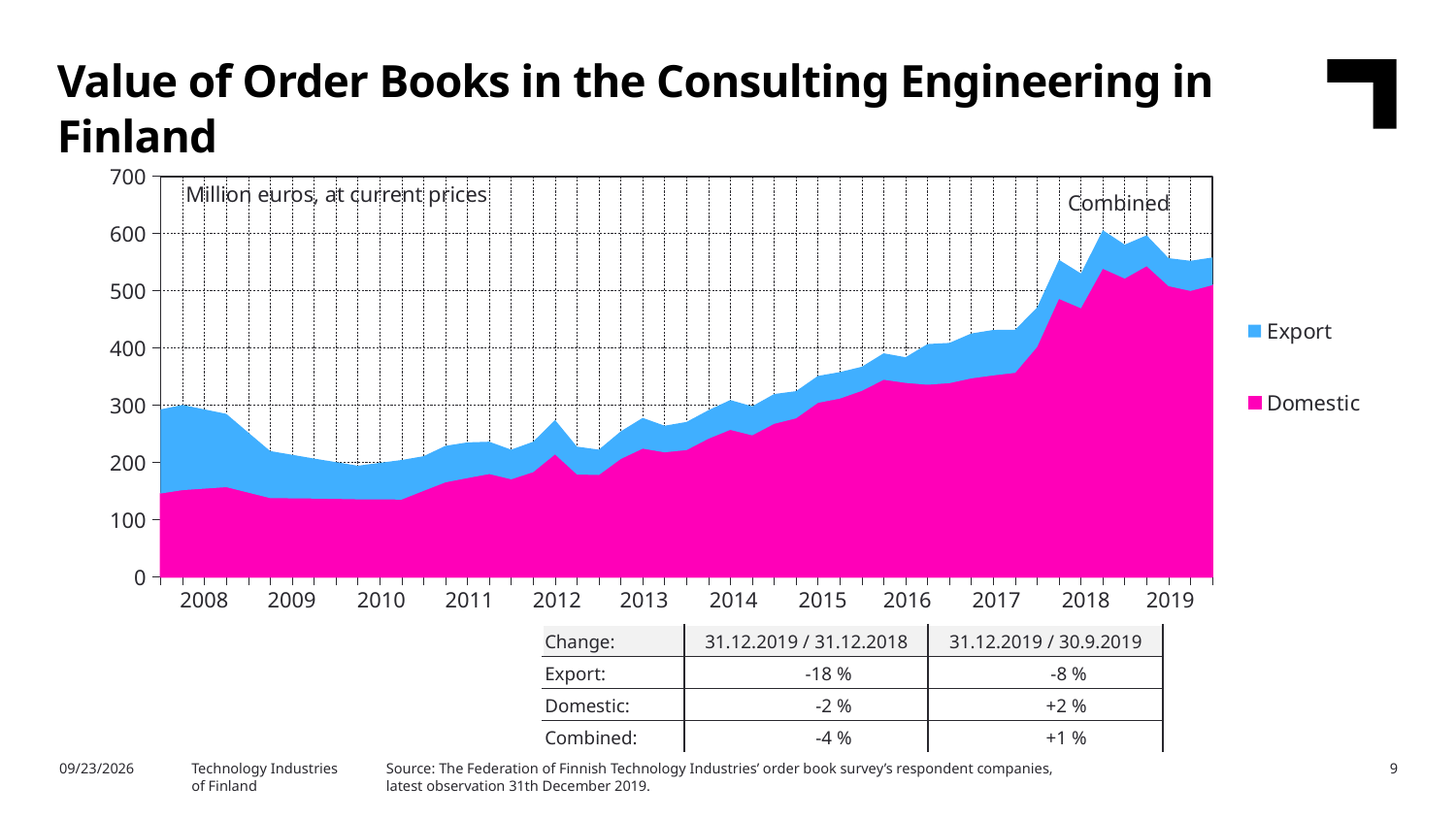
Is the Combined value at the start of 2010 greater or less than 300? less Which two series are listed in the legend? Export and Domestic What is the highest value shown on the vertical axis? 700 According to the table, what is the Export change from 31.12.2018 to 31.12.2019? -18 % Does the Combined value generally rise or fall from 2010 to 2018? rise What unit is stated on the chart for the values? Million euros, at current prices How many series does the legend list? 2 Is the Combined value in 2018 greater or less than 500? greater Is the Domestic value at the start of 2008 greater or less than 200? less What kind of chart is shown on the slide? Stacked area chart According to the table, what is the Combined change from 30.9.2019 to 31.12.2019? +1 %